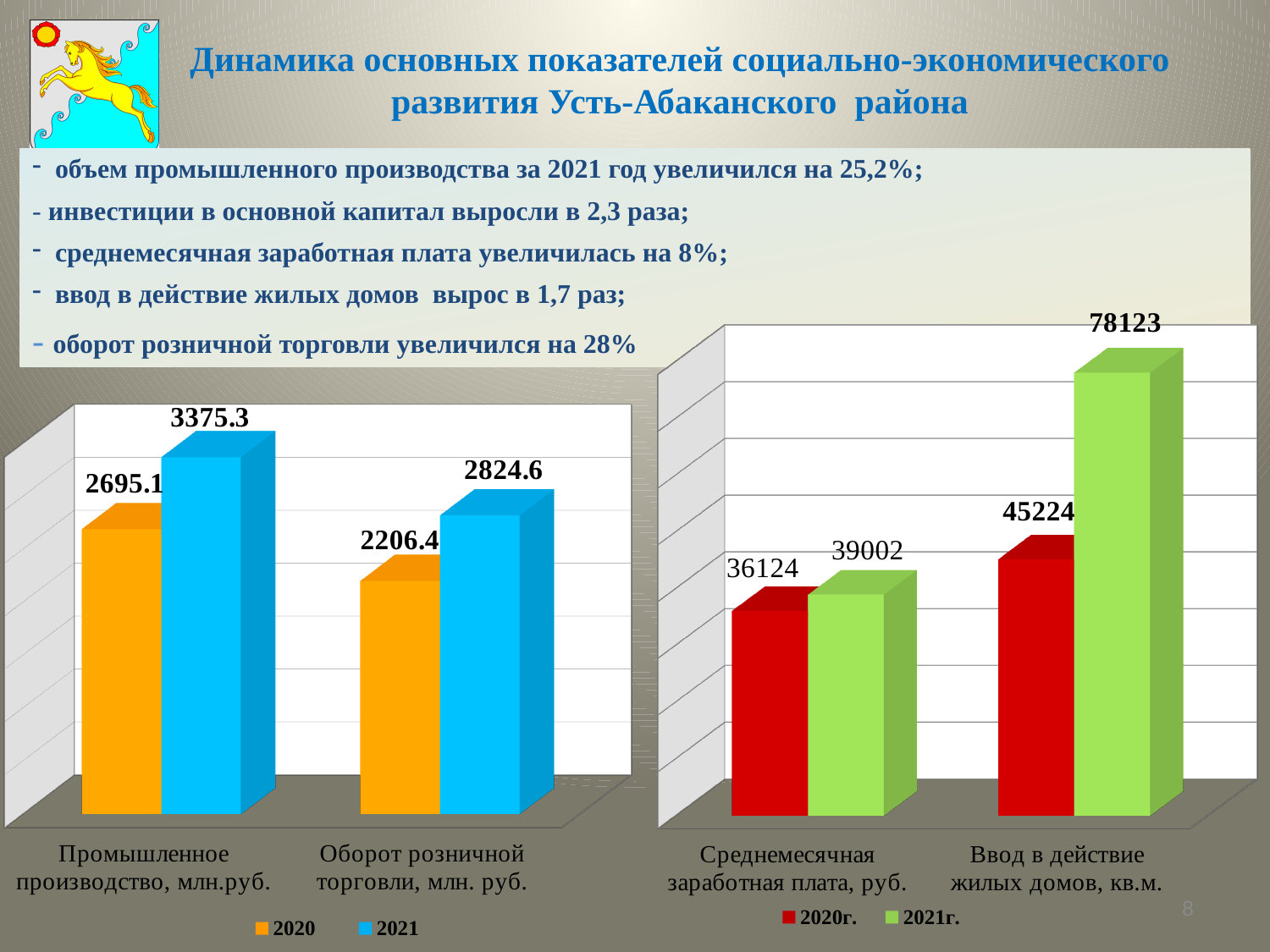
How many series does the legend of the right chart list? 2 In the left chart, which bar has the lowest value? Оборот розничной торговли, 2020 What kind of chart is the right chart? Bar chart In the right chart, what is the value for Среднемесячная заработная плата in 2021г.? 39002 In the left chart, what is the difference between the 2021 and 2020 values for Промышленное производство? 680.2 In the left chart, what is the value for Оборот розничной торговли in 2020? 2206.4 In the left chart, what is the value for Промышленное производство in 2021? 3375.3 In the right chart, which bar has the highest value? Ввод в действие жилых домов, 2021г. How many categories are shown on the x axis of the left chart? 2 In the right chart, what is the value for Ввод в действие жилых домов in 2020г.? 45224 In the right chart, what is the difference between the 2021г. and 2020г. values for Ввод в действие жилых домов? 32899 In the left chart, which is larger: Оборот розничной торговли in 2021 or Промышленное производство in 2020? Оборот розничной торговли in 2021